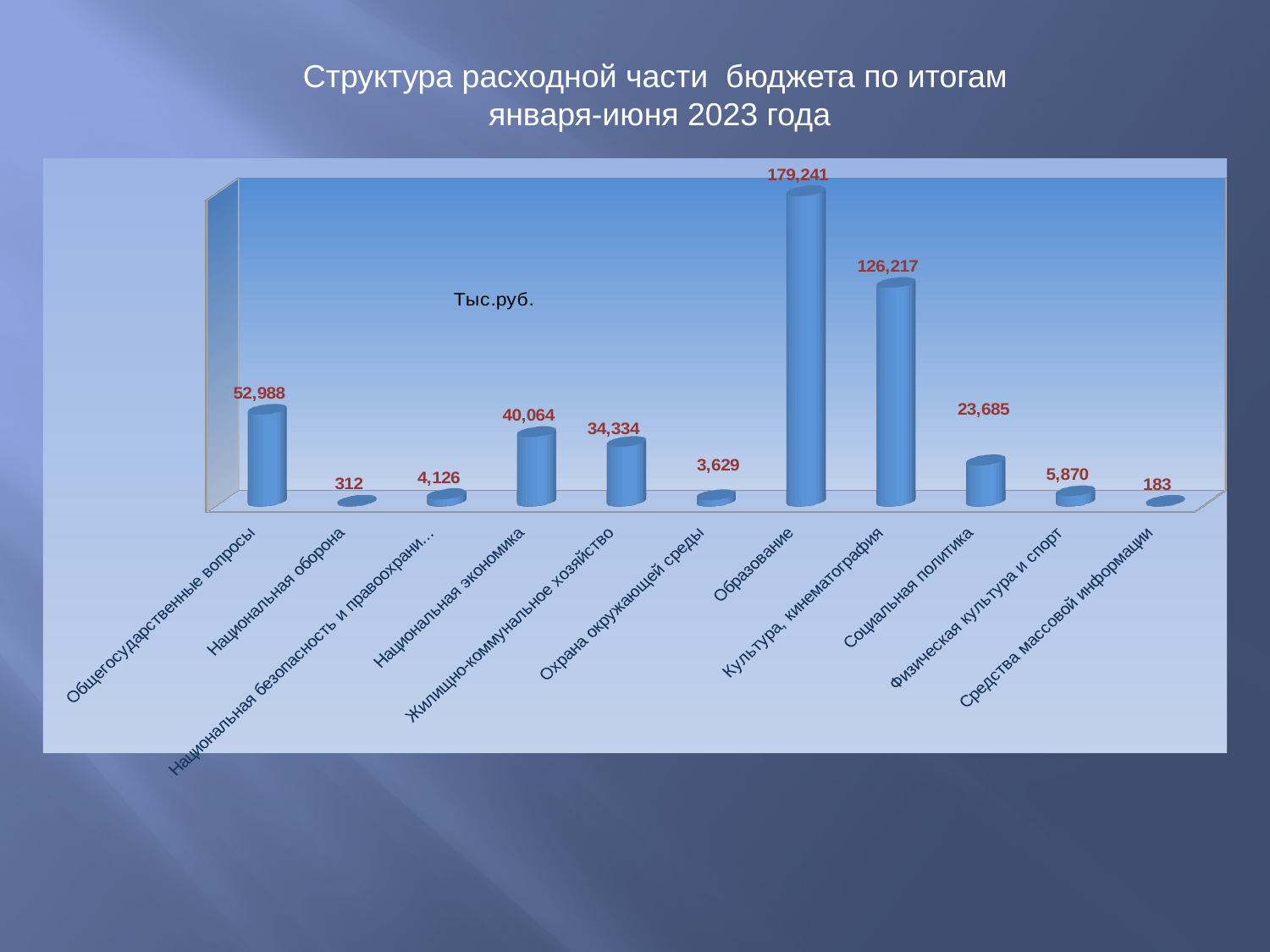
What is the difference between the values for Общегосударственные вопросы and Национальная экономика? 12,924 Which category has the highest value? Образование What is the value for Социальная политика? 23,685 What is the difference between the values for Образование and Культура, кинематография? 53,024 Which is larger, the value for Национальная экономика or the value for Жилищно-коммунальное хозяйство? Национальная экономика What is the value for Образование? 179,241 Which category has the lowest value? Средства массовой информации How many categories are shown on the chart? 11 What unit is indicated on the chart? Тыс.руб. What is the value for Жилищно-коммунальное хозяйство? 34,334 What kind of chart is shown on the slide? Bar chart What is the value for Культура, кинематография? 126,217